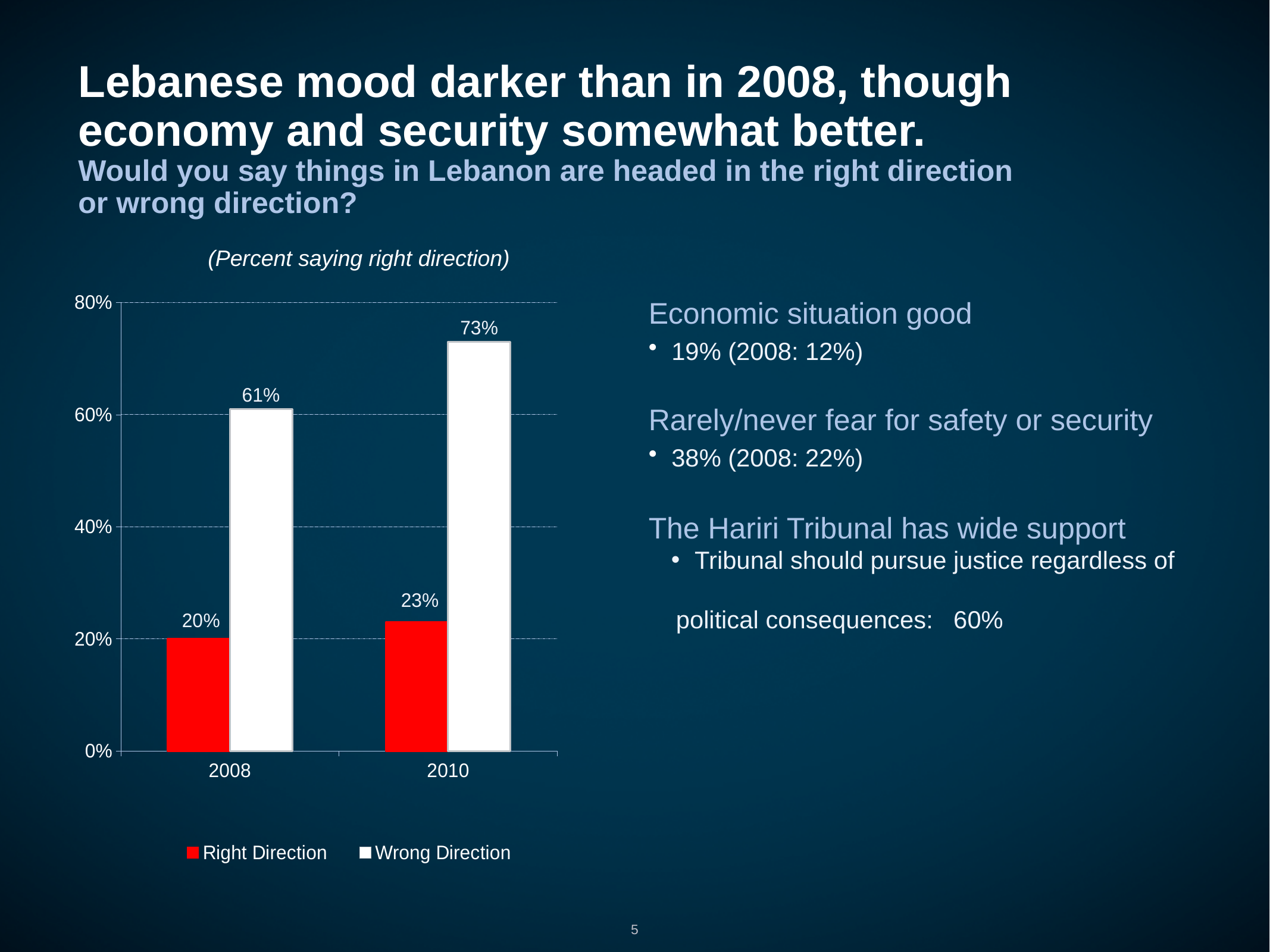
Which is larger in 2008: Right Direction or Wrong Direction? Wrong Direction Does the Right Direction value rise or fall from 2008 to 2010? rise What is the value for Wrong Direction in 2008? 61% What is the value for Right Direction in 2008? 20% How many series does the legend list? 2 What is the difference between the Wrong Direction values for 2010 and 2008? 12% What is the value for Wrong Direction in 2010? 73% What is the value for Right Direction in 2010? 23% How many years are shown on the x axis? 2 Which year has the highest Wrong Direction value? 2010 Which year has the lowest Right Direction value? 2008 What kind of chart is shown? bar chart